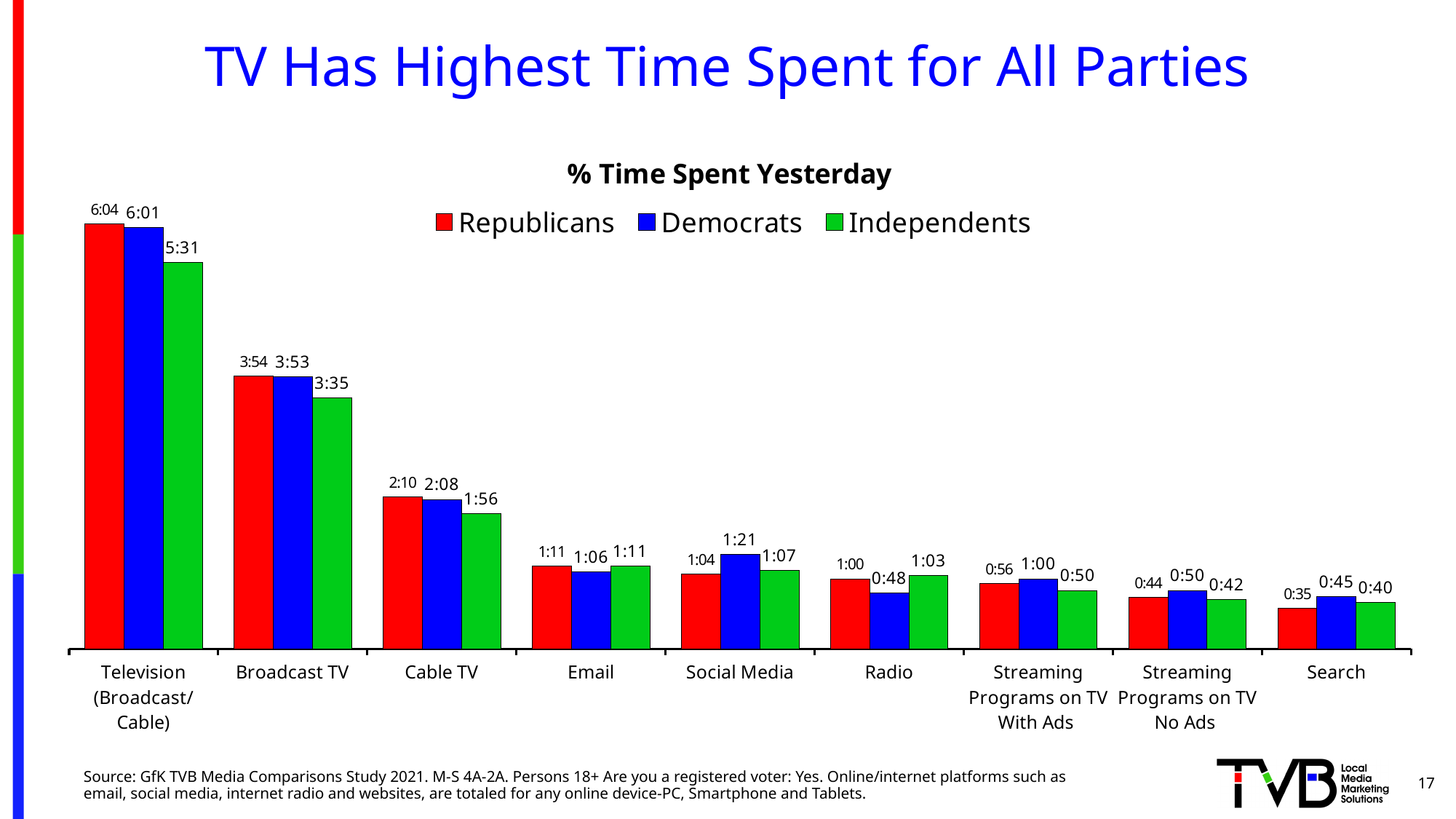
In the Email category, which is larger: the Republicans value or the Democrats value? Republicans How many series does the legend list? 3 What is the value for Independents in the Broadcast TV category? 3:35 Which category has the highest value for Independents? Television (Broadcast/Cable) What is the value for Republicans in the Television (Broadcast/Cable) category? 6:04 What is the value for Democrats in the Social Media category? 1:21 How many categories are shown on the x axis? 9 What is the value for Democrats in the Radio category? 0:48 In the Social Media category, how much larger is the Democrats value than the Republicans value? 17 minutes Do the Republicans values rise or fall moving from left to right across the categories? Fall Which category has the lowest value for Republicans? Search What kind of chart is shown on the slide? Bar chart